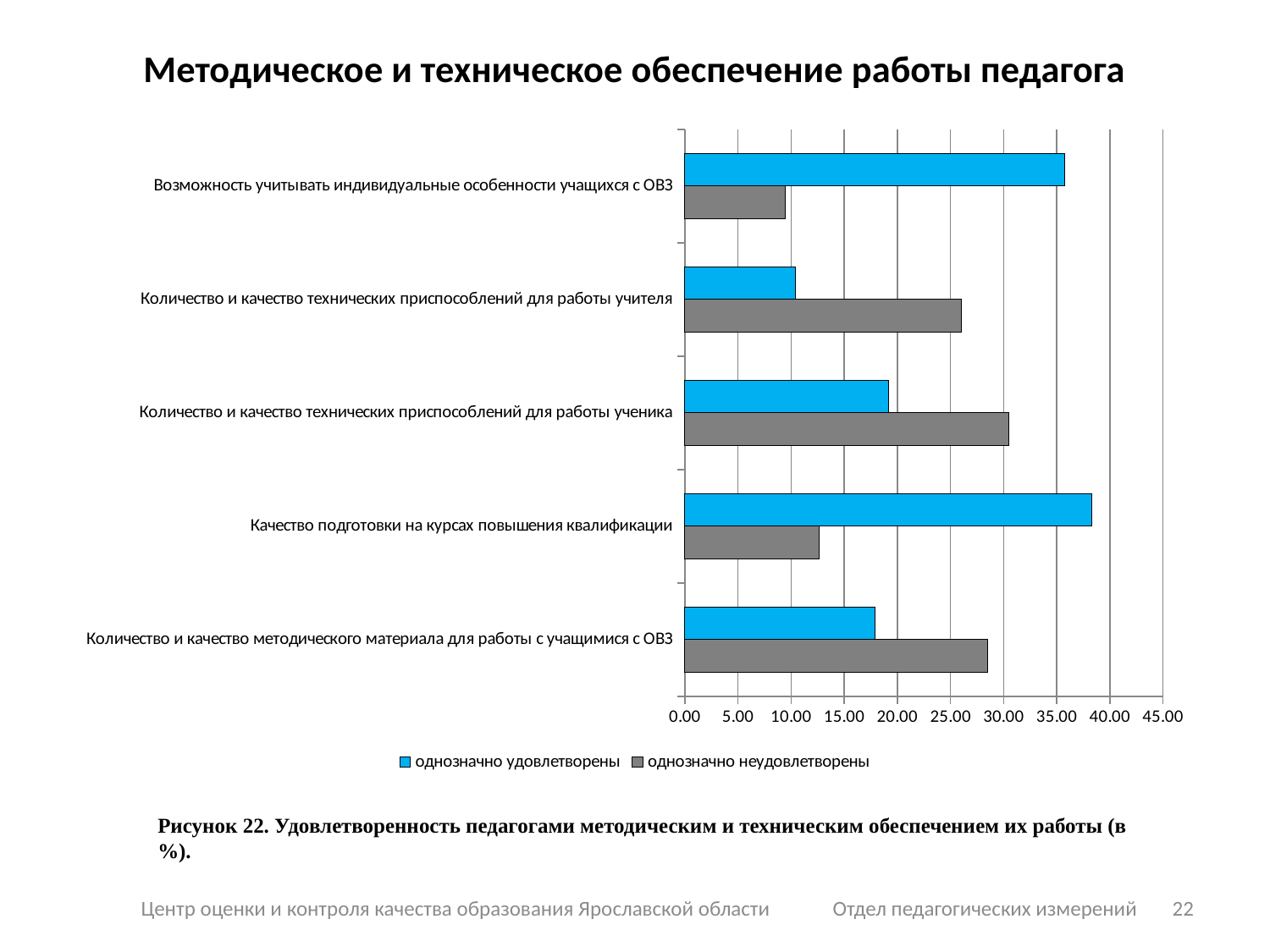
For 'Количество и качество технических приспособлений для работы учителя', which series has the larger value: 'однозначно удовлетворены' or 'однозначно неудовлетворены'? однозначно неудовлетворены Is the value for 'однозначно удовлетворены' in 'Количество и качество методического материала для работы с учащимися с ОВЗ' greater or less than 25.00? less Is the value for 'однозначно удовлетворены' in 'Качество подготовки на курсах повышения квалификации' greater or less than 35.00? greater Is the value for 'однозначно неудовлетворены' in 'Возможность учитывать индивидуальные особенности учащихся с ОВЗ' greater or less than 15.00? less How many series does the legend list? 2 For 'Возможность учитывать индивидуальные особенности учащихся с ОВЗ', which series has the larger value: 'однозначно удовлетворены' or 'однозначно неудовлетворены'? однозначно удовлетворены What colour are the bars for the series 'однозначно неудовлетворены'? grey Which category has the lowest value for 'однозначно удовлетворены'? Количество и качество технических приспособлений для работы учителя What kind of chart is shown on the slide? bar chart Which category has the lowest value for 'однозначно неудовлетворены'? Возможность учитывать индивидуальные особенности учащихся с ОВЗ How many categories are shown on the chart? 5